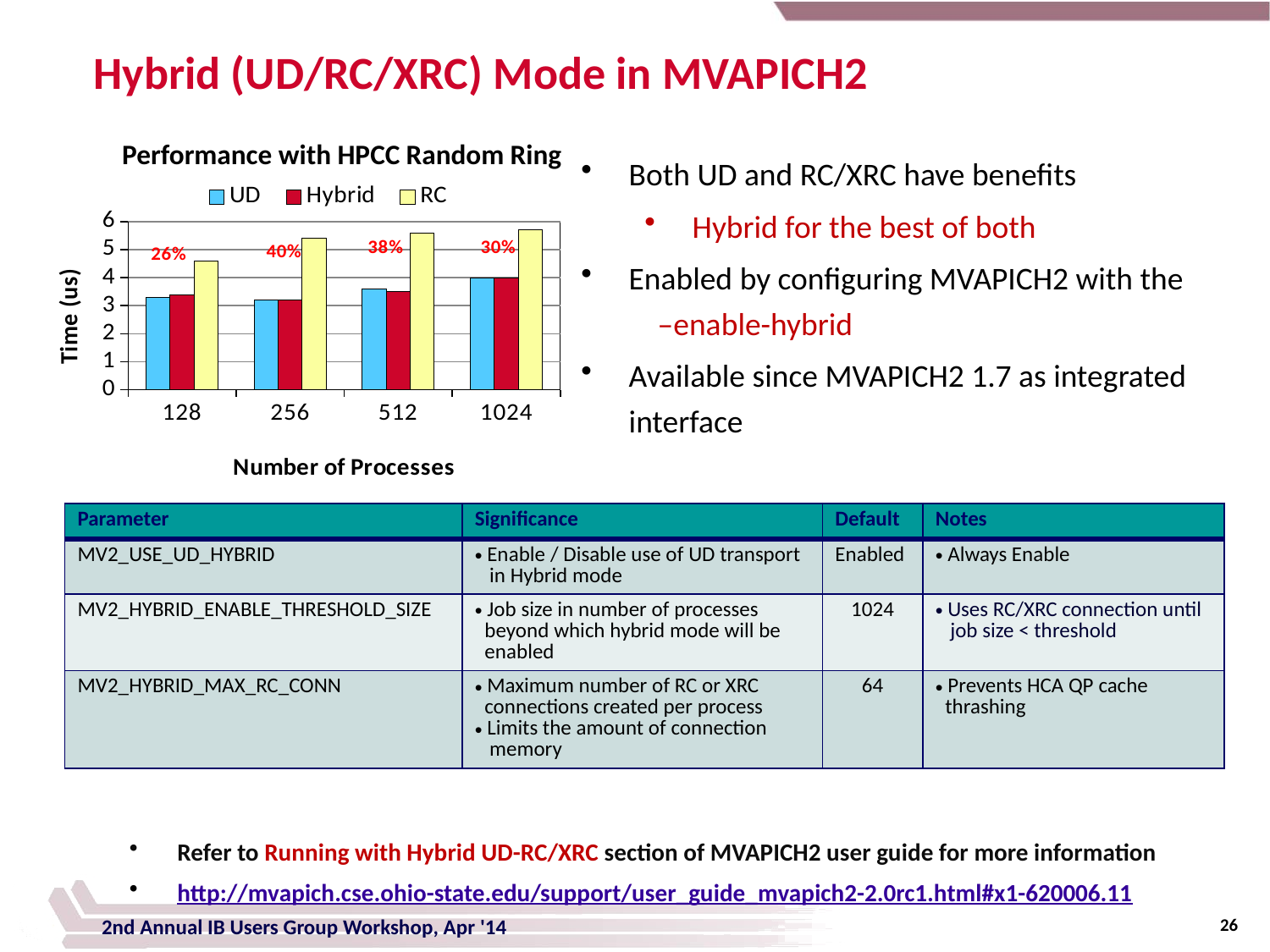
What percentage label is printed above the 128-process group in the chart? 26% What type of chart is shown under the title 'Performance with HPCC Random Ring'? Bar chart Which series has the highest time at 1024 processes? RC What is the label of the y axis of the chart? Time (us) Is the RC time at 1024 processes greater or less than 5 us? greater Is the RC time at 128 processes greater or less than 4 us? greater Does the RC time rise or fall as the number of processes increases from 128 to 1024? rise How many process-count categories are shown on the x axis of the chart? 4 Which series has the highest time at 128 processes? RC How many series does the legend of the 'Performance with HPCC Random Ring' chart list? 3 What percentage label is printed above the 256-process group in the chart? 40% Is the UD time at 128 processes greater or less than 4 us? less